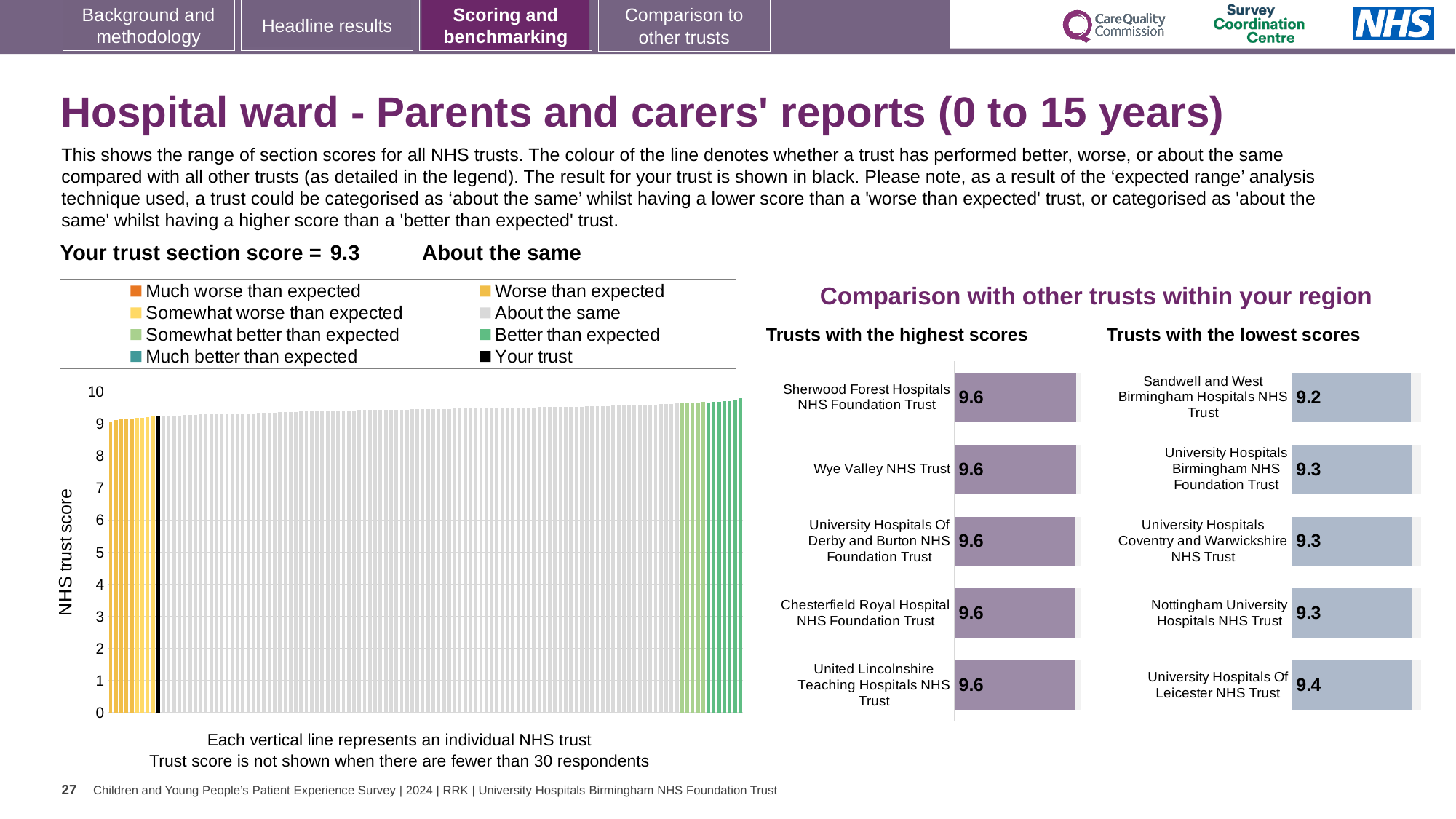
How many trusts are listed in the 'Trusts with the highest scores' chart? 5 In the 'NHS trust score' chart on the left, is the value for the black 'Your trust' bar greater or less than 9? greater In the 'Trusts with the lowest scores' chart, what is the score for Sandwell and West Birmingham Hospitals NHS Trust? 9.2 How many entries does the legend above the 'NHS trust score' chart list? 8 In the 'NHS trust score' chart on the left, do the bar values rise or fall from left to right along the x axis? rise What kind of chart is the 'NHS trust score' chart on the left? bar chart In the 'Trusts with the highest scores' chart, what is the score for Wye Valley NHS Trust? 9.6 In the 'Trusts with the lowest scores' chart, is the score for University Hospitals Of Leicester NHS Trust larger or smaller than the score for Nottingham University Hospitals NHS Trust? larger In the 'Trusts with the lowest scores' chart, what is the score for University Hospitals Of Leicester NHS Trust? 9.4 In the 'Trusts with the lowest scores' chart, which trust has the lowest score? Sandwell and West Birmingham Hospitals NHS Trust In the 'Trusts with the lowest scores' chart, which trust has the highest score? University Hospitals Of Leicester NHS Trust What is the difference between the score for Sherwood Forest Hospitals NHS Foundation Trust in the highest scores chart and the score for Sandwell and West Birmingham Hospitals NHS Trust in the lowest scores chart? 0.4